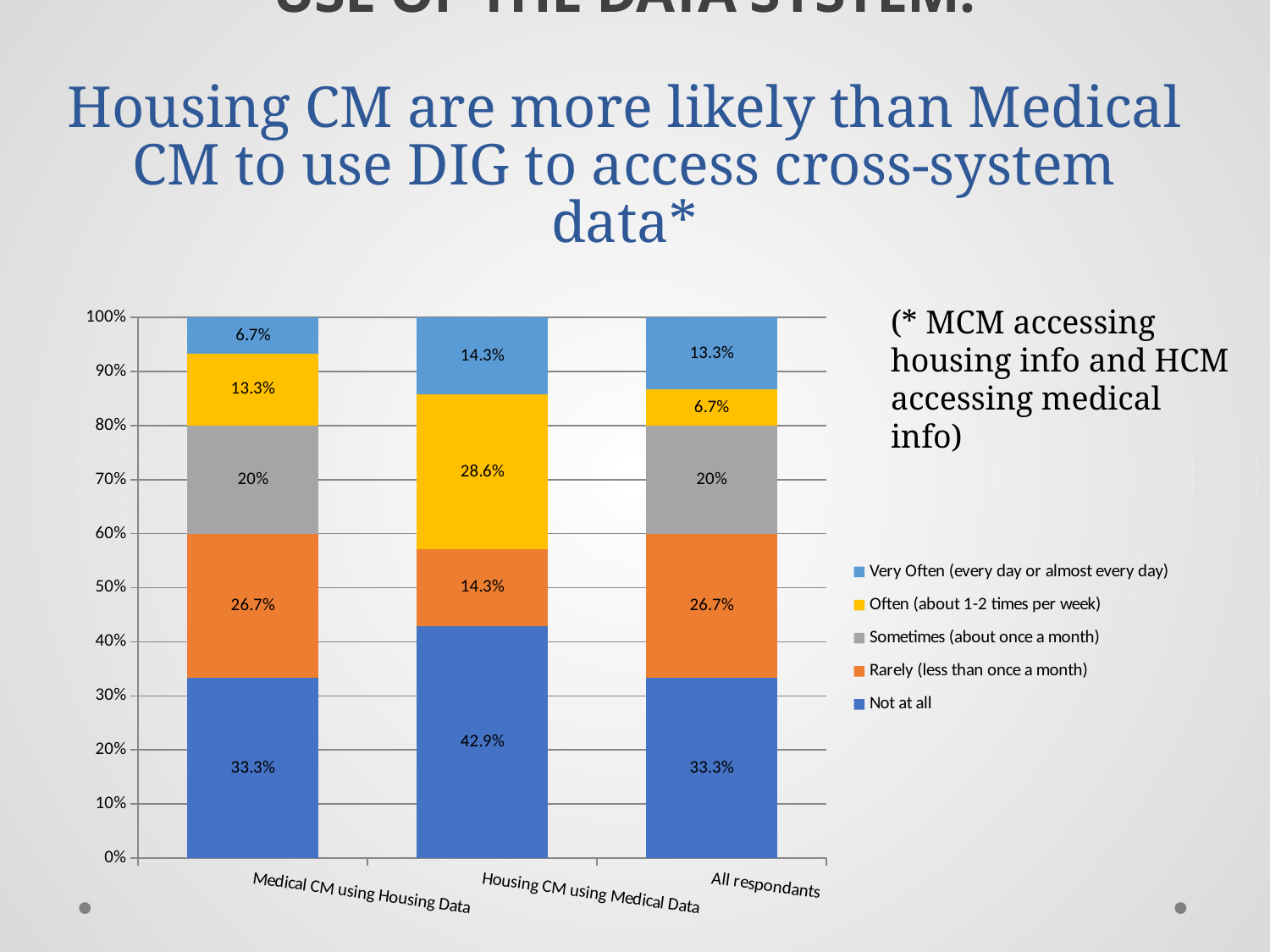
What is the value for "Not at all" for Housing CM using Medical Data? 42.9% What kind of chart is shown on the slide? Stacked bar chart What is the value for "Very Often (every day or almost every day)" for All respondants? 13.3% Which category has the highest value for "Not at all"? Housing CM using Medical Data What is the value for "Rarely (less than once a month)" for Housing CM using Medical Data? 14.3% How many series does the legend list? 5 How many categories are shown on the x axis? 3 What is the value for "Often (about 1-2 times per week)" for Medical CM using Housing Data? 13.3% What is the difference in percentage points between the "Often (about 1-2 times per week)" values for Housing CM using Medical Data and Medical CM using Housing Data? 15.3 Which is larger: the "Rarely (less than once a month)" value for Medical CM using Housing Data or for Housing CM using Medical Data? Medical CM using Housing Data What is the value for "Sometimes (about once a month)" for All respondants? 20% Which category has the lowest value for "Very Often (every day or almost every day)"? Medical CM using Housing Data